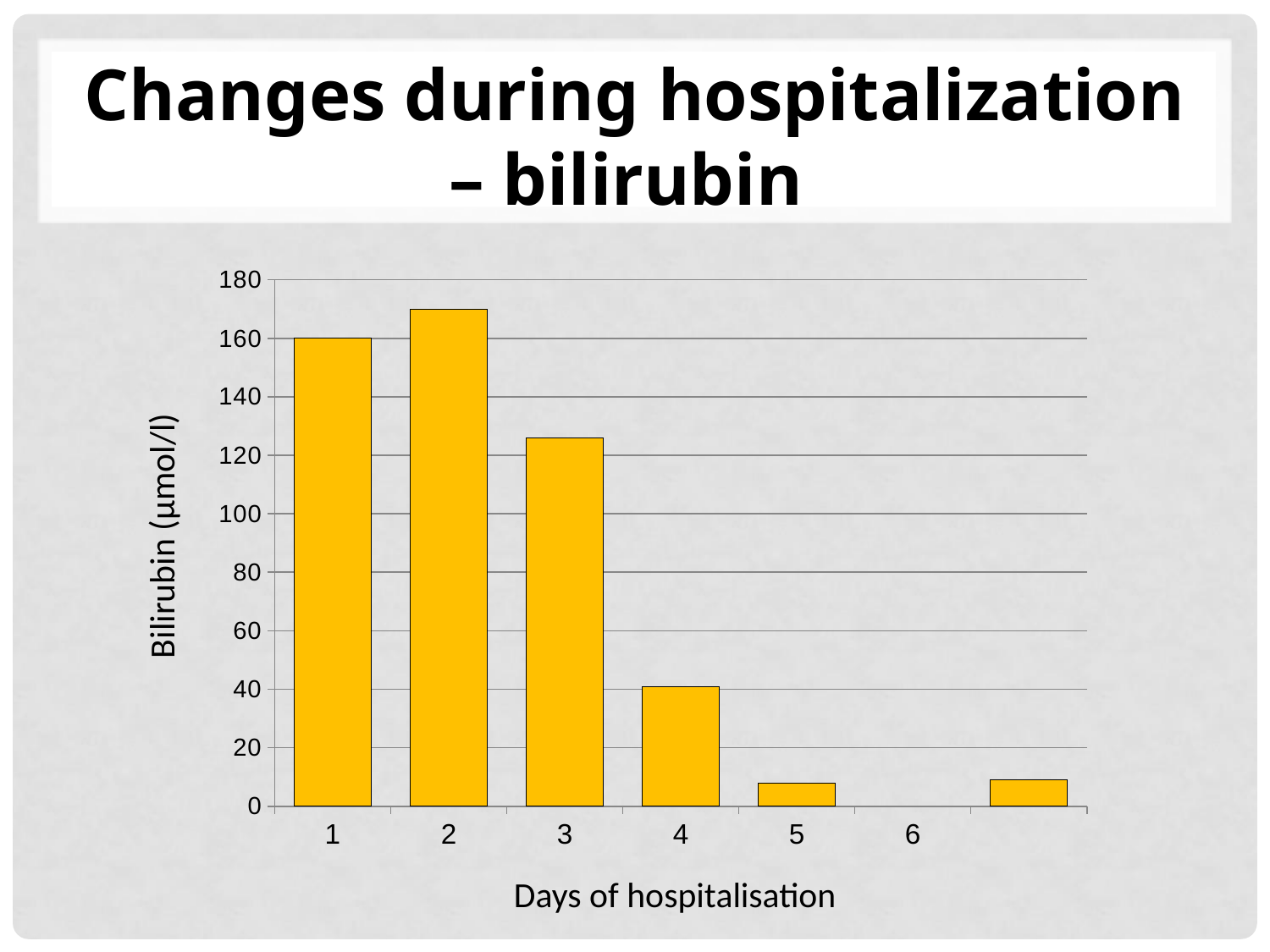
Is the bilirubin value for day 2 greater or less than 160? greater Which has the higher bilirubin value, day 1 or day 3? day 1 Is the bilirubin value for day 5 greater or less than 20? less Which has the higher bilirubin value, day 4 or day 5? day 4 What is the label of the y axis? Bilirubin (µmol/l) What is the label of the x axis? Days of hospitalisation What kind of chart is shown on the slide? bar chart Is the bilirubin value for day 4 greater or less than 60? less Which day of hospitalisation has the highest bilirubin value? 2 From day 2 to day 5, do the bilirubin values rise or fall? fall How many days are labeled on the x axis? 6